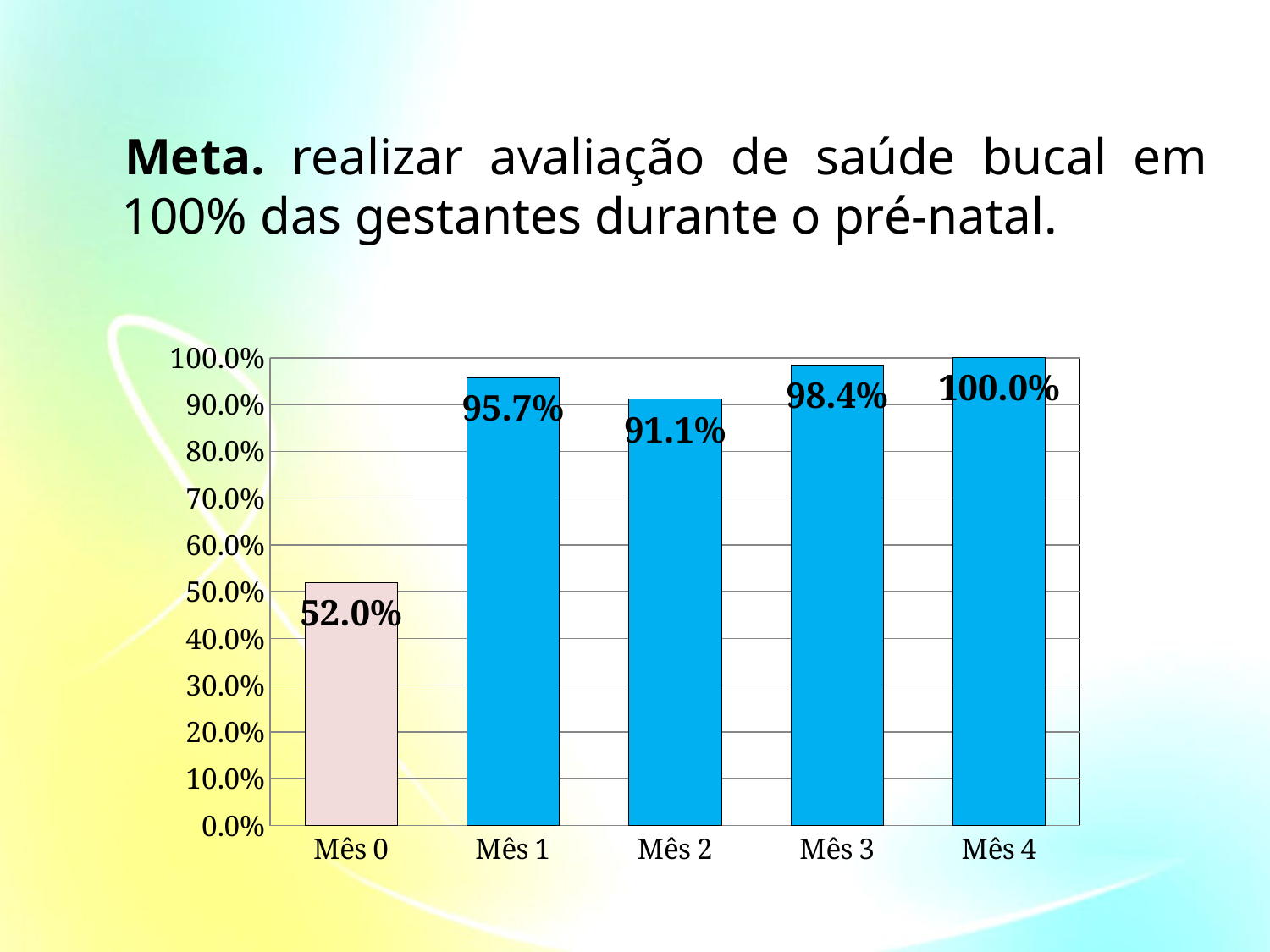
What is the difference between the values for Mês 4 and Mês 0? 48.0% What is the value for Mês 3? 98.4% Is the value for Mês 0 greater or less than 60.0%? less How many categories are shown on the x axis? 5 What is the value for Mês 2? 91.1% Which category has the lowest value? Mês 0 What kind of chart is shown on the slide? bar chart Which category has the highest value? Mês 4 What is the difference between the values for Mês 1 and Mês 2? 4.6% Which is larger, the value for Mês 1 or the value for Mês 2? Mês 1 What is the value for Mês 0? 52.0% Which bar is shown in a different colour from the others? Mês 0